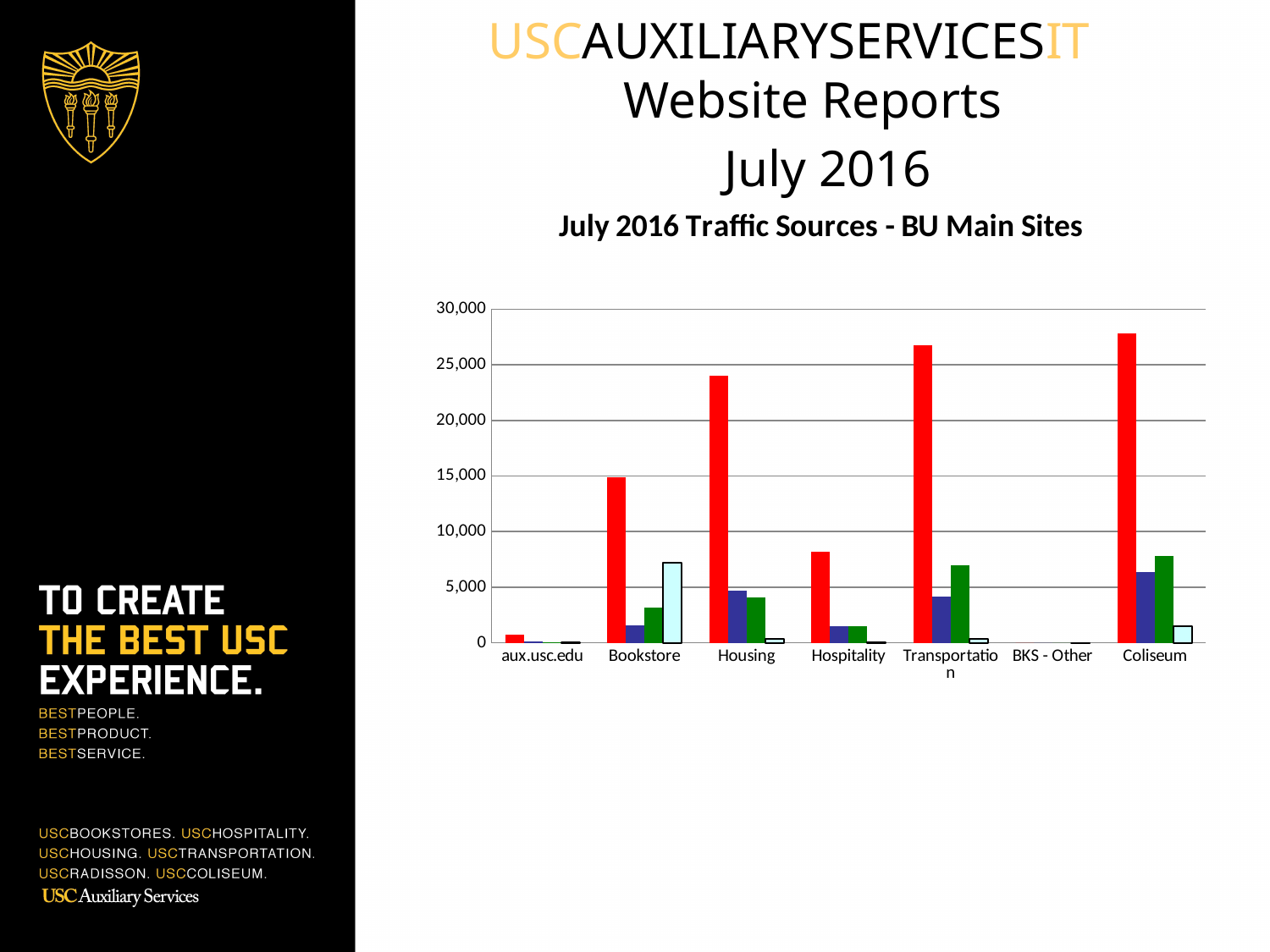
How many categories are shown on the x axis of the chart? 7 Is the red bar for Transportation greater or less than 25,000? greater What is the title of the chart? July 2016 Traffic Sources - BU Main Sites Which has the larger red bar, Housing or Hospitality? Housing Is the red bar for Housing greater or less than 25,000? less What type of chart is shown on the slide? bar chart Which category has the tallest red bar? Coliseum Is the green bar for Housing greater or less than 5,000? less Which category has the smallest red bar? BKS - Other